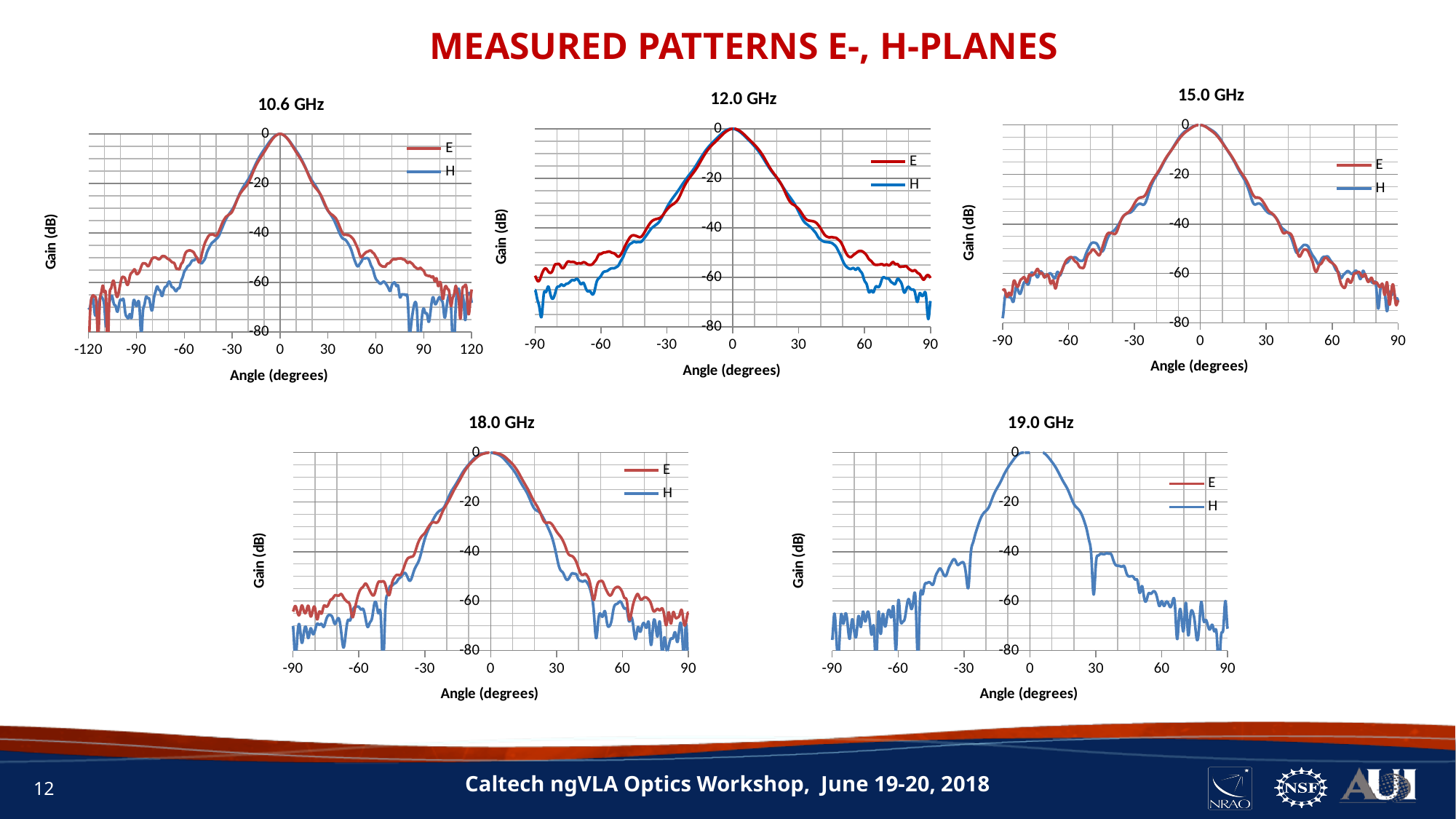
What kind of chart is the 10.6 GHz chart? line chart How many series does the legend of the 12.0 GHz chart list? 2 In the 12.0 GHz chart, what is the gain at 0 degrees? 0 In the 18.0 GHz chart, is the H value at 90 degrees greater or less than -40? less In the 19.0 GHz chart, is the H value at 0 degrees greater or less than -20? greater In the 15.0 GHz chart, at which angle is the gain highest? 0 How many charts are shown on the slide? 5 What are the legend entries in the 15.0 GHz chart? E and H In the 10.6 GHz chart, does the gain rise or fall as the angle goes from 0 to 90 degrees? fall In the 12.0 GHz chart, at -90 degrees, which series has the higher gain, E or H? E In the 12.0 GHz chart, is the E value at -90 degrees greater or less than -40? less In the 18.0 GHz chart, what colour is the H series line? blue